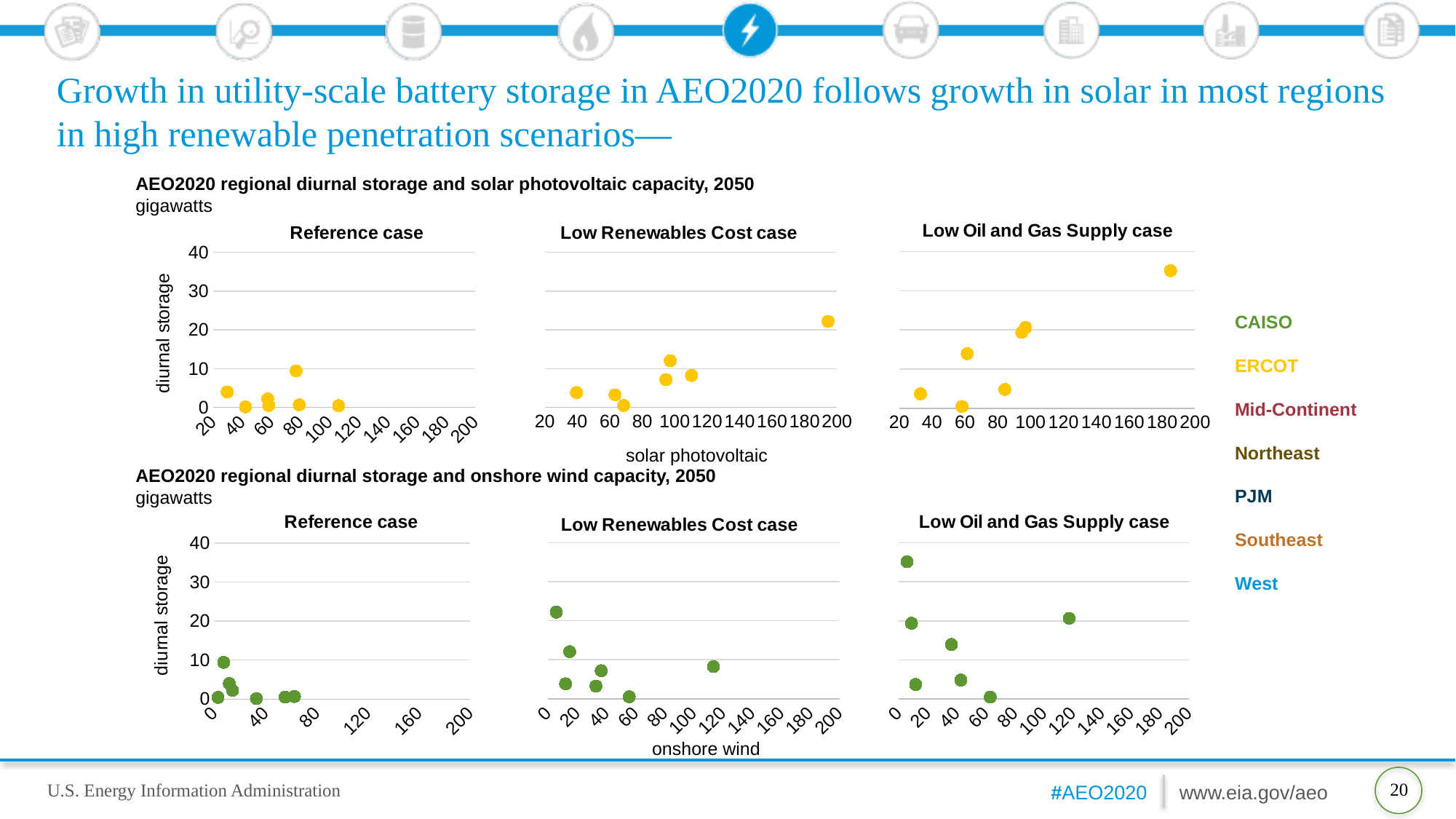
In the top-row Low Oil and Gas Supply case chart, is the highest diurnal storage value greater or less than 30? greater What kind of chart is used in the 'AEO2020 regional diurnal storage and solar photovoltaic capacity, 2050' panels? Scatter chart In the top-row Low Renewables Cost case chart, is the diurnal storage value of the point with the largest solar photovoltaic capacity greater or less than 20? greater How many points are plotted in the top-row Reference case chart (diurnal storage vs solar photovoltaic)? 7 In the top-row Reference case chart, is the highest diurnal storage value greater or less than 20? less How many regions does the legend on the right of the slide list? 7 What is the x-axis label shared by the bottom row of charts? onshore wind What unit is given for the values in the charts on this slide? gigawatts Among the three onshore wind charts in the bottom row, which case contains the point with the highest diurnal storage? Low Oil and Gas Supply case Among the three solar photovoltaic charts in the top row, which case contains the point with the highest diurnal storage? Low Oil and Gas Supply case How many points are plotted in the bottom-row Low Oil and Gas Supply case chart (diurnal storage vs onshore wind)? 7